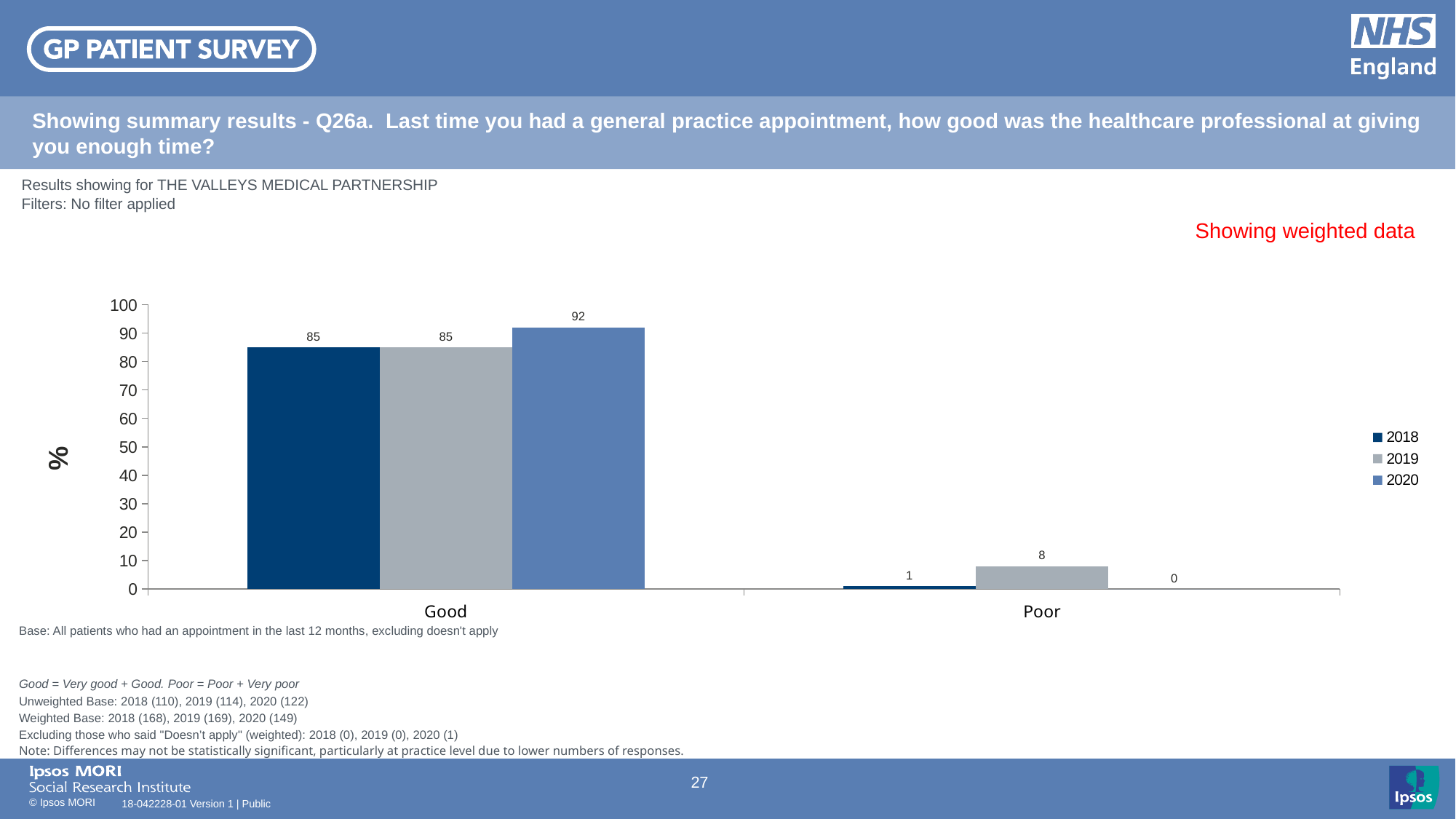
What is the value for Poor in 2020? 0 What is the difference between the Good values for 2020 and 2019? 7 What is the label on the vertical axis? % What kind of chart is shown on the slide? Bar chart How many series does the legend list? 3 Is the value for Good in 2020 greater or less than 90? greater Which is larger, the Poor value for 2019 or the Poor value for 2018? 2019 What is the value for Poor in 2019? 8 Which year has the lowest value for Poor? 2020 What is the value for Good in 2020? 92 Which year has the highest value for Good? 2020 What is the value for Good in 2018? 85